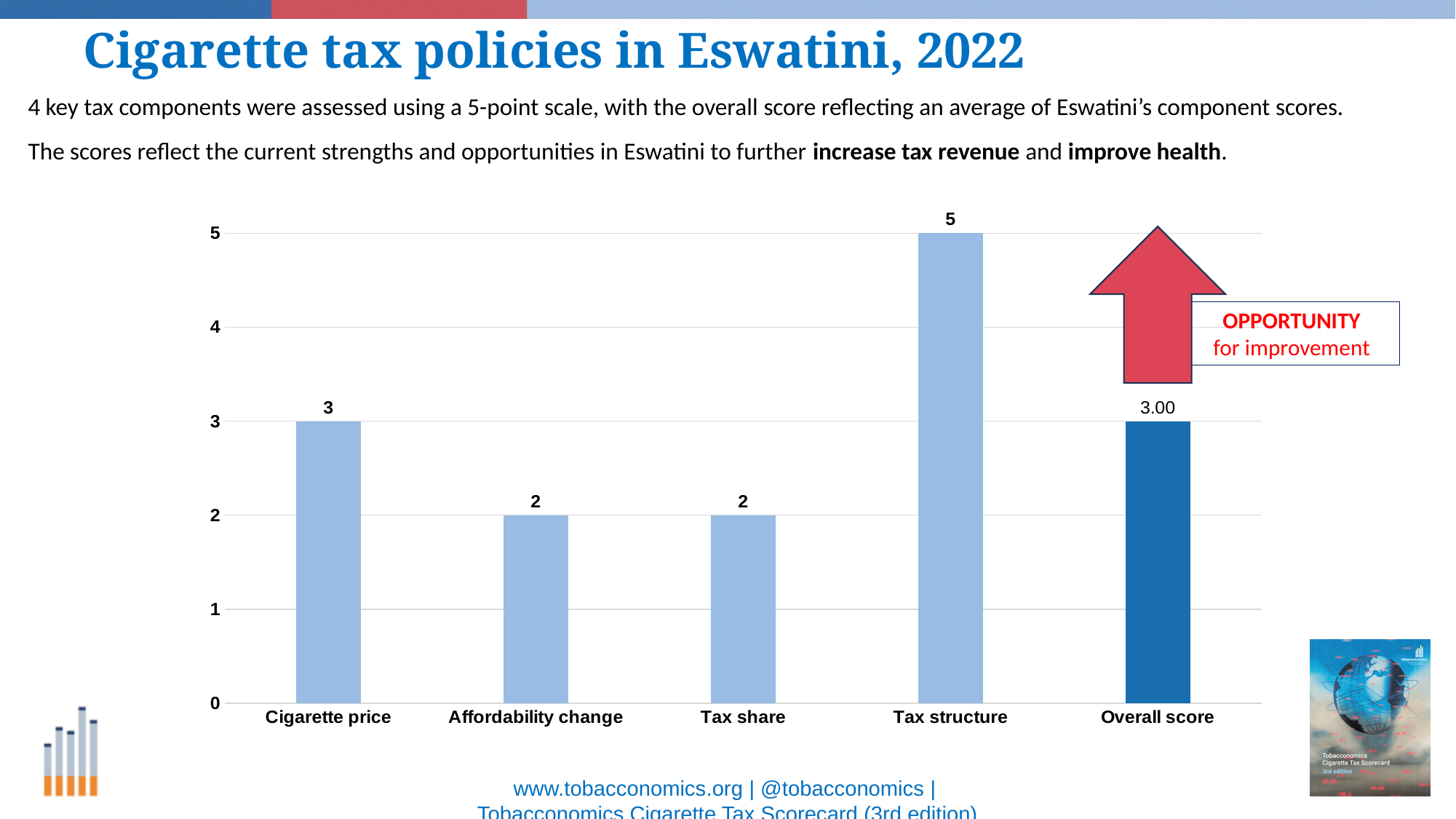
What is the difference between the Cigarette price score and the Tax share score? 1 How many bars are shown in the chart? 5 What is the value shown for Overall score? 3.00 Which bar is shown in a darker blue than the others? Overall score Is the value for Tax structure greater or less than 4? greater What is the score for Cigarette price? 3 What kind of chart is shown on the slide? bar chart What is the score for Tax structure? 5 What is the difference between the Tax structure score and the Tax share score? 3 Which is larger, the score for Cigarette price or the score for Affordability change? Cigarette price What is the score for Affordability change? 2 Which component has the highest score? Tax structure